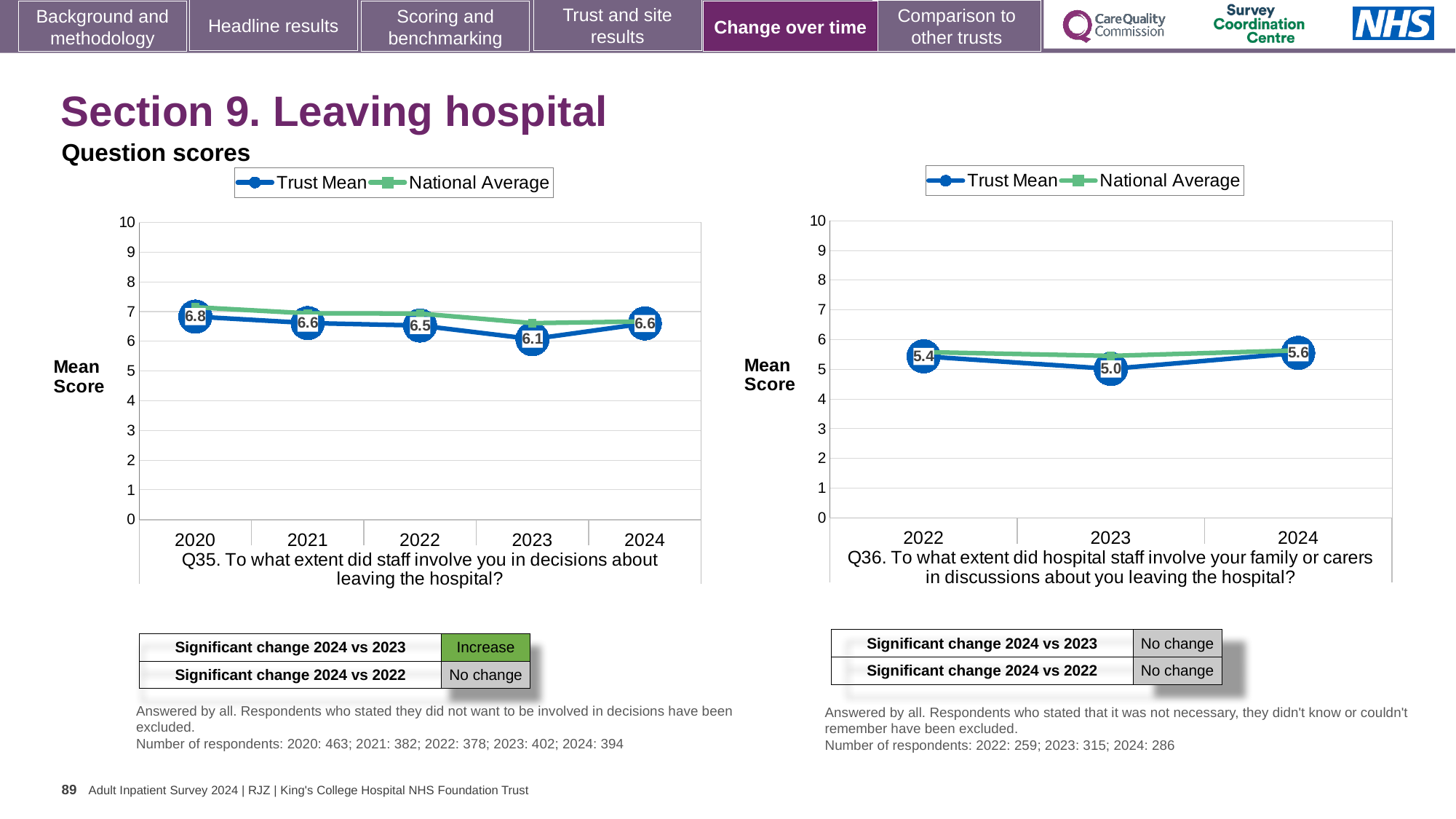
What kind of chart is the Q36 chart on the right? Line chart In the Q36 chart on the right, is the Trust Mean score for 2023 greater or less than 6? less In the Q35 chart on the left, what is the difference between the Trust Mean scores for 2024 and 2023? 0.5 How many years are plotted on the x axis of the Q35 chart on the left? 5 In the Q35 chart on the left, which year has the highest Trust Mean score? 2020 In the Q36 chart on the right, what is the difference between the Trust Mean scores for 2024 and 2022? 0.2 In the Q36 chart on the right, what is the Trust Mean score for 2023? 5.0 In the Q35 chart on the left, what is the Trust Mean score for 2020? 6.8 In the Q35 chart on the left, which year has the lowest Trust Mean score? 2023 In the Q36 chart on the right, which year has the highest Trust Mean score? 2024 How many series does the legend of the Q36 chart on the right list? 2 In the Q35 chart on the left, what is the Trust Mean score for 2023? 6.1